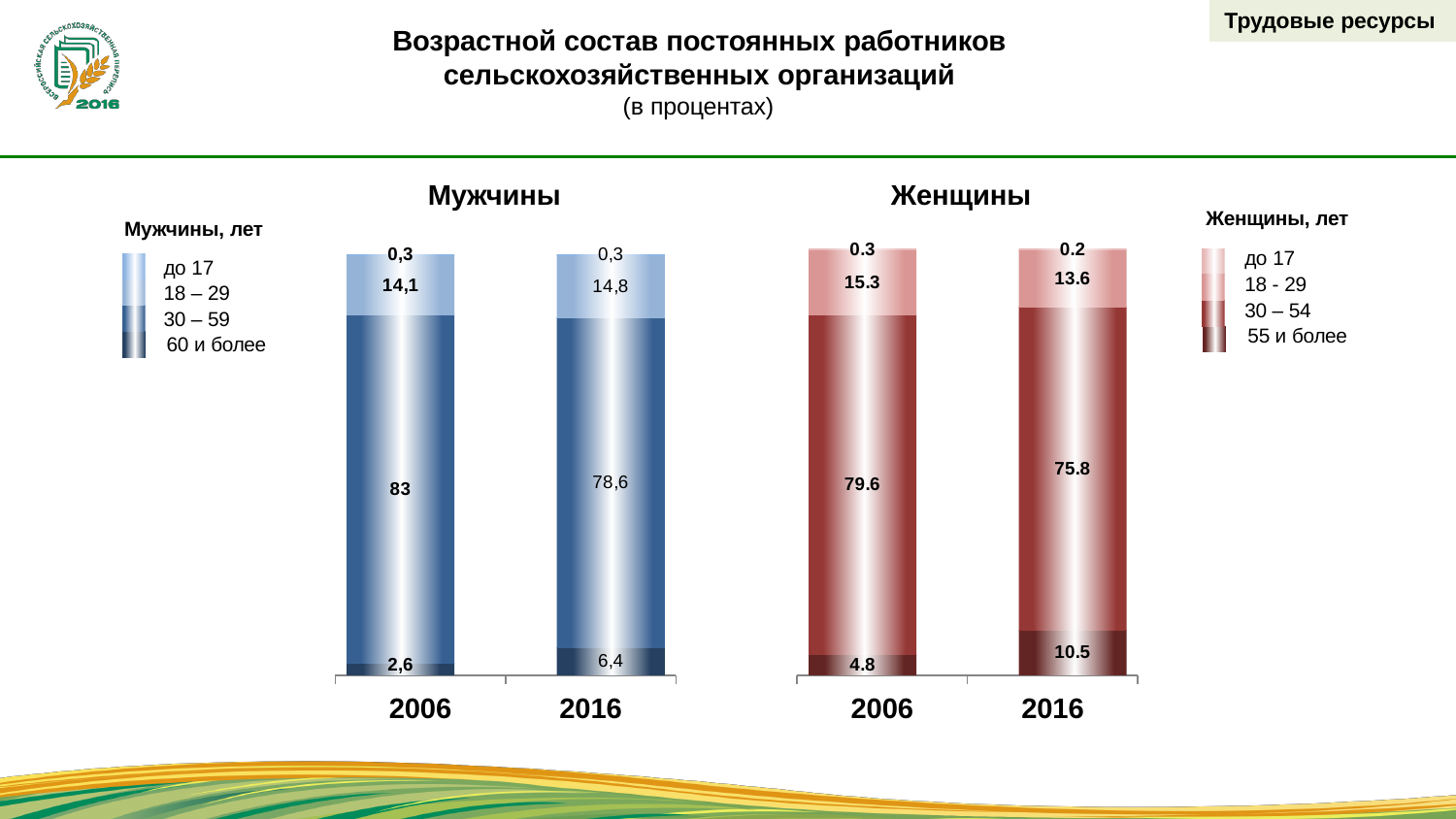
In the "Мужчины" chart, what is the value for the 60 и более age group in 2016? 6,4 In the "Мужчины" chart, by how much did the 30 – 59 share fall from 2006 to 2016? 4,4 In the "Женщины" chart, what is the value for the 55 и более age group in 2016? 10.5 In the "Мужчины" chart, which age group has the largest share in 2016? 30 – 59 How many age groups does the legend of the "Мужчины" chart list? 4 In the "Женщины" chart, what is the value for the до 17 age group in 2016? 0.2 In the "Женщины" chart, how did the 30 – 54 share change from 2006 to 2016? It fell What type of chart is used for the "Женщины" data? Stacked bar chart In the "Женщины" chart, what is the value for the 18 - 29 age group in 2006? 15.3 In the "Женщины" chart, which age group has the smallest share in 2006? до 17 In the "Мужчины" chart, what is the value for the 30 – 59 age group in 2006? 83 In the "Женщины" chart, which is larger: the 55 и более share in 2006 or in 2016? 2016